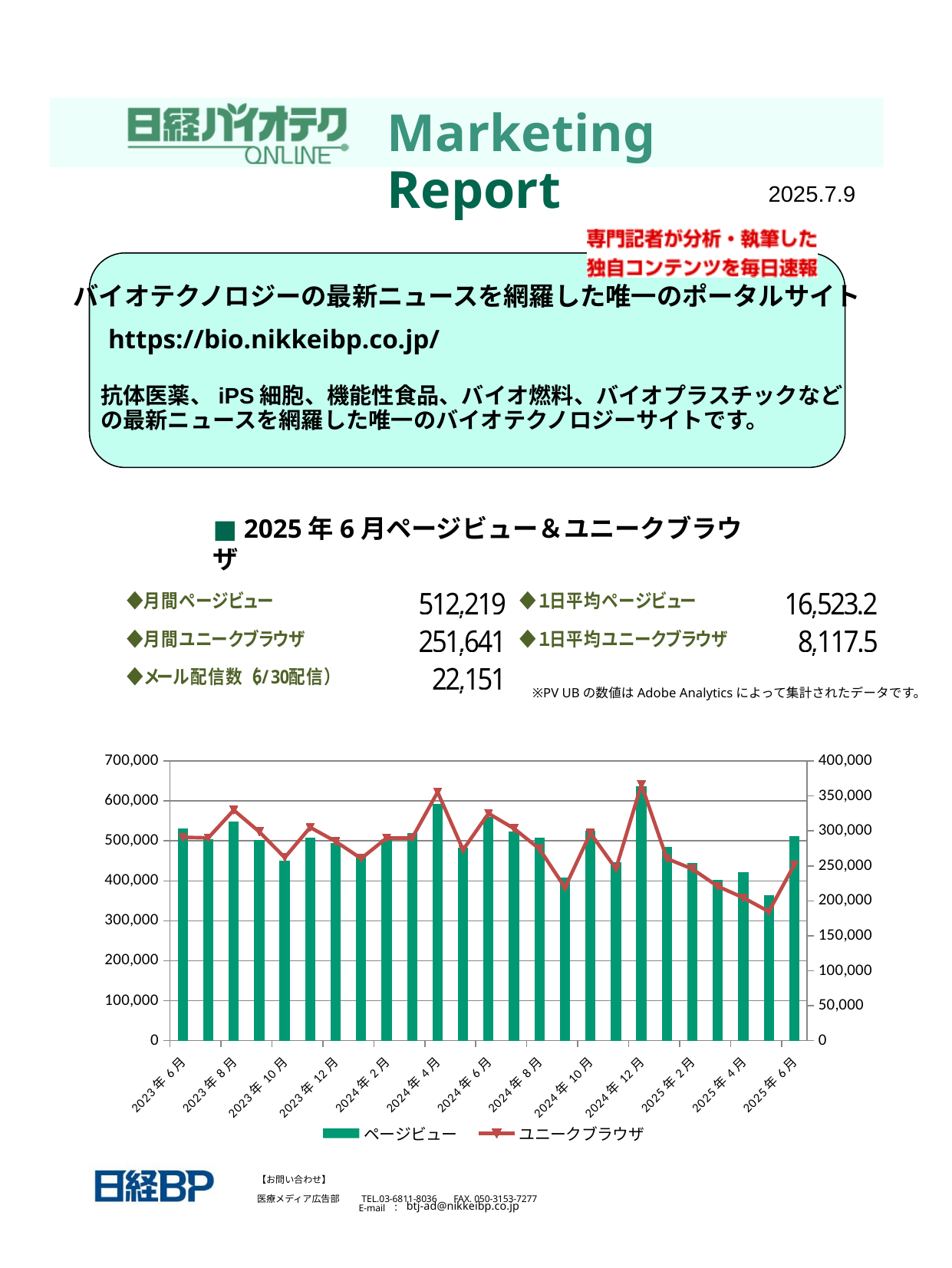
Do the ページビュー values rise or fall from 2024年12月 to 2025年2月? fall Is the ページビュー value for 2025年4月 greater or less than 500,000? less Which has the larger ページビュー value, 2024年4月 or 2024年10月? 2024年4月 How many series does the chart legend list? 2 What kind of chart is shown on the slide? A combination bar and line chart How many monthly bars are plotted in the chart? 25 Is the ユニークブラウザ value for 2025年6月 greater or less than 300,000? less Which labeled month has the highest ページビュー bar? 2024年12月 Is the ユニークブラウザ value for 2024年4月 greater or less than 300,000? greater What are the two series named in the chart legend? ページビュー and ユニークブラウザ Which series is drawn as bars in the chart? ページビュー